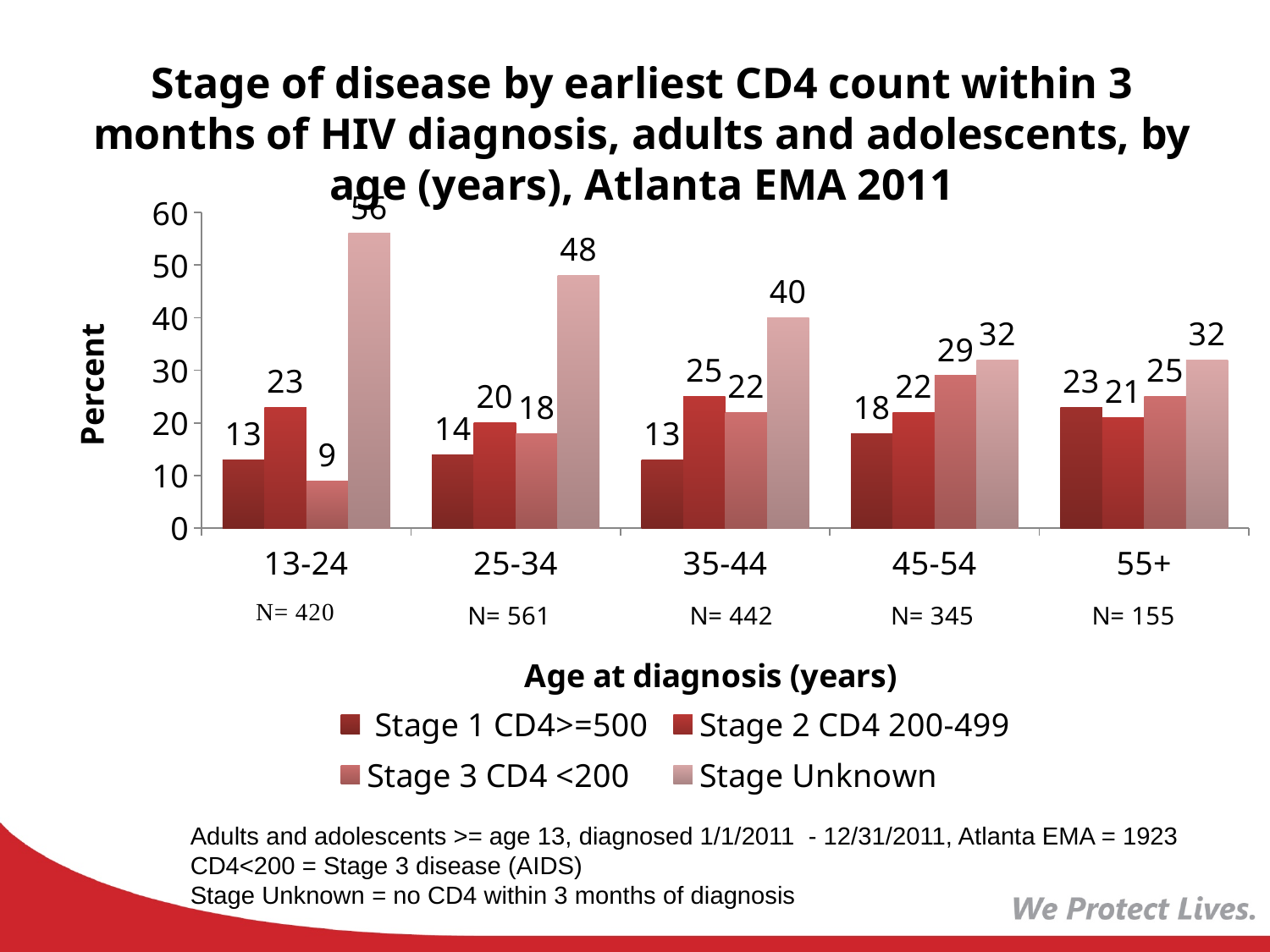
How many age groups are shown on the x axis? 5 What kind of chart is shown on the slide? Bar chart Which age group has the highest value for Stage Unknown? 13-24 What is the value for Stage Unknown in the 13-24 age group? 56 Which age group has the larger value for Stage 1 CD4>=500, 45-54 or 55+? 55+ Which age group has the lowest value for Stage 3 CD4 <200? 13-24 What is the label of the y axis? Percent What is the difference between the Stage Unknown values for the 13-24 and 25-34 age groups? 8 What is the value for Stage 2 CD4 200-499 in the 35-44 age group? 25 How many series does the legend list? 4 What is the value for Stage 3 CD4 <200 in the 45-54 age group? 29 Do the Stage Unknown values rise or fall as age at diagnosis increases from 13-24 to 45-54? Fall